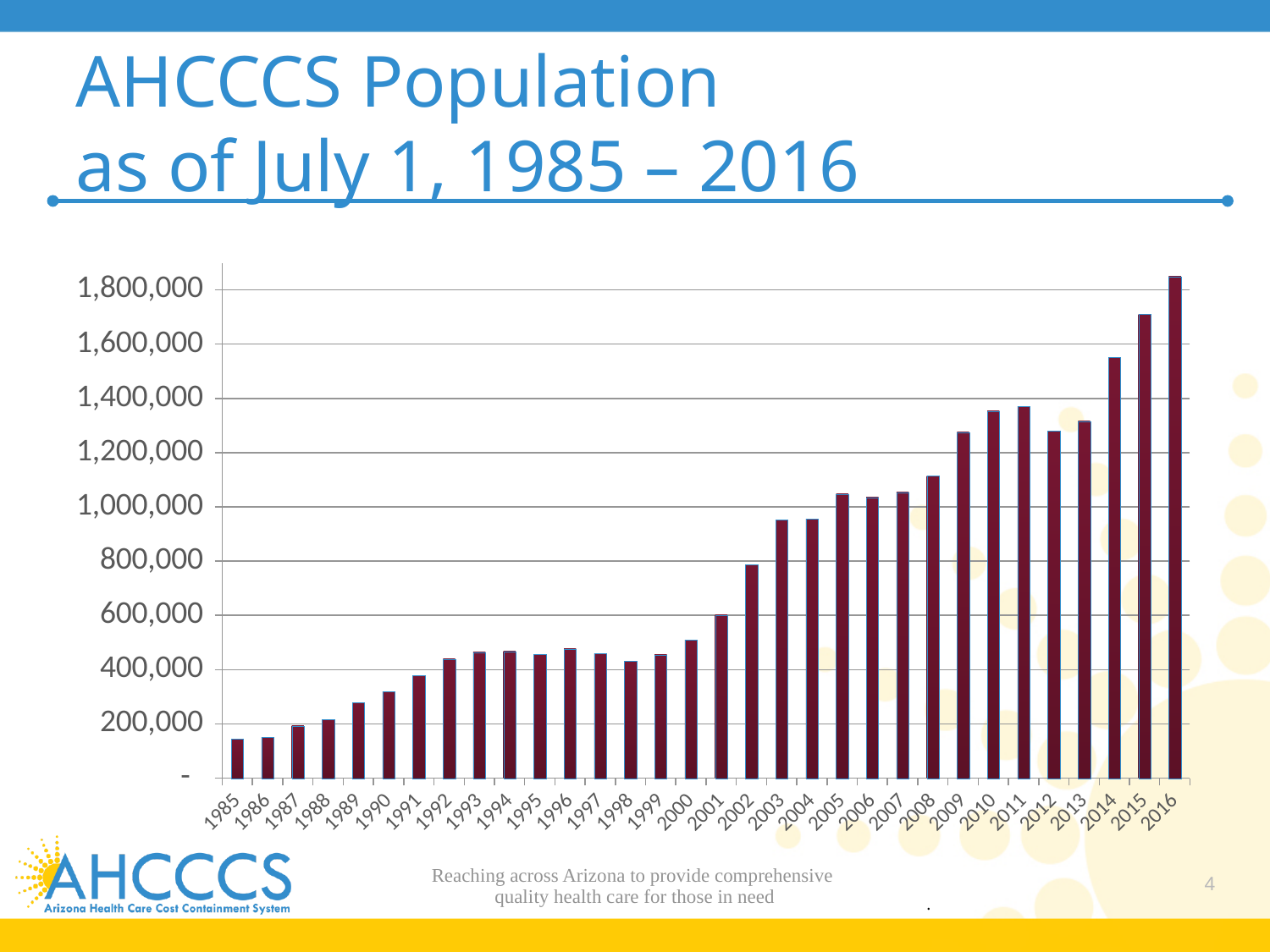
Is the value for 2016 greater or less than 1,800,000? greater Overall, do the values rise or fall from 1985 to 2016? rise Which is larger, the value for 2001 or the value for 2002? 2002 Is the value for 2003 greater or less than 1,000,000? less Is the value for 1990 greater or less than 200,000? greater What kind of chart is shown on the slide? bar chart Which is larger, the value for 2014 or the value for 2012? 2014 How many years are plotted on the chart? 32 Which year has the highest AHCCCS population? 2016